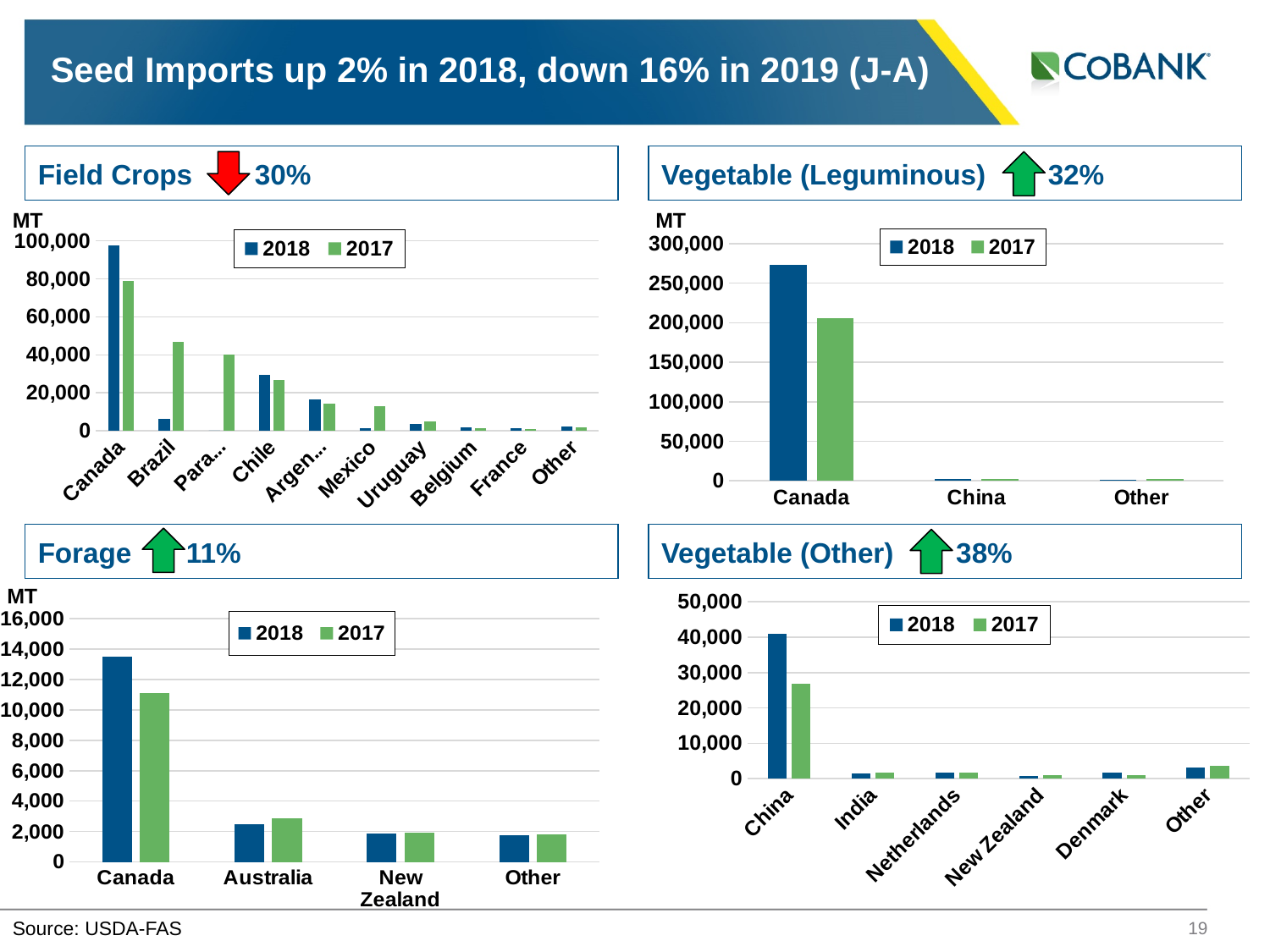
How many series does the legend of the Vegetable (Leguminous) chart list? 2 In the Vegetable (Leguminous) chart, is the 2017 value for Canada greater or less than 250,000? less In the Vegetable (Leguminous) chart, is the 2018 value for Canada greater or less than 250,000? greater In the Field Crops chart, is the 2018 value for Canada greater or less than 80,000? greater In the Field Crops chart, is the 2018 value for Brazil larger or smaller than its 2017 value? smaller What kind of chart is the Forage chart? bar chart How many categories are shown on the x axis of the Field Crops chart? 10 In the Field Crops chart, which category has the highest 2018 value? Canada What percentage change is shown next to the Forage chart title? 11%